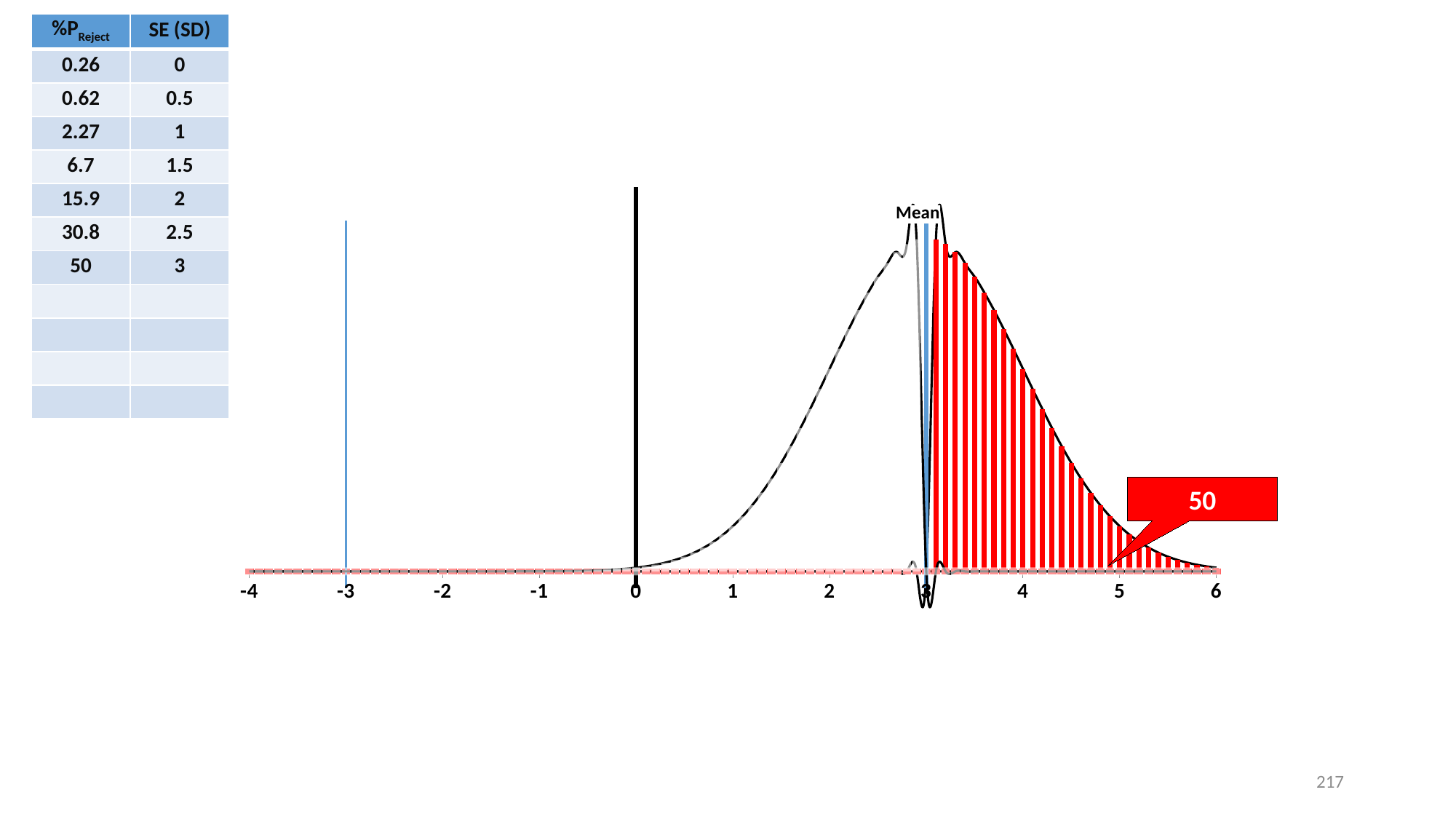
At which x-axis value is the thick black vertical line drawn on the chart? 0 What value is shown in the red callout pointing to the shaded area of the chart? 50 What label is printed above the blue vertical line near x = 3 on the chart? Mean What kind of chart is shown on the slide? line chart Does the curve on the chart rise or fall as x goes from 4 to 6? fall Is the red shaded region on the chart to the left or to the right of the Mean line? right What is the lowest value labelled on the chart's x axis? -4 At which x-axis value is the thin blue vertical line on the left side of the chart drawn? -3 Is the peak of the curve on the chart to the left or to the right of x = 0? right Does the curve on the chart rise or fall as x goes from 0 to 2? rise What is the highest value labelled on the chart's x axis? 6 How many tick labels are printed along the chart's x axis? 11